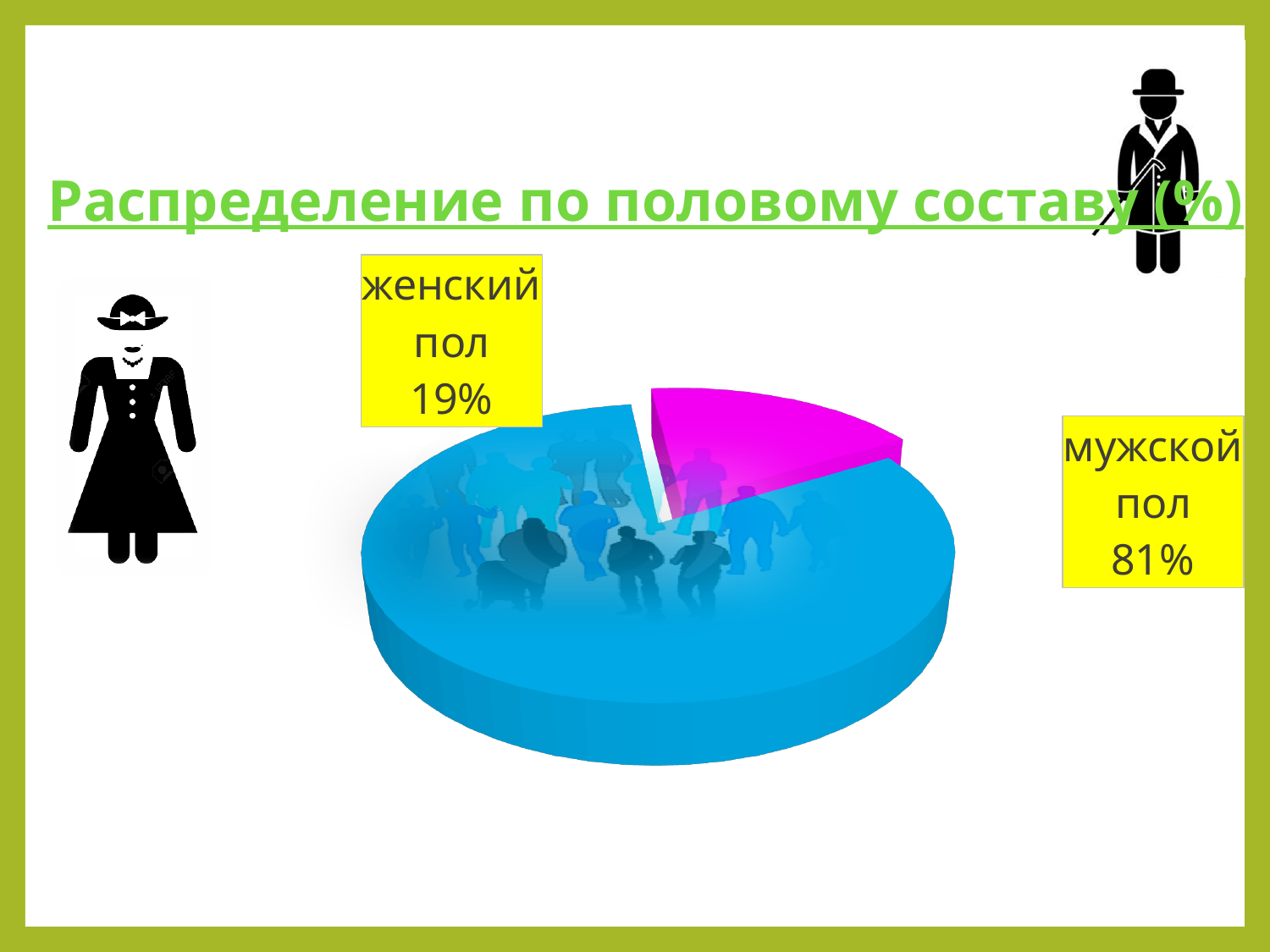
What percentage does the slice labelled "женский пол" represent? 19% Which category has the smallest share of the pie? женский пол Which is larger: the share for "женский пол" or the share for "мужской пол"? мужской пол What is the difference in percentage points between the "мужской пол" and "женский пол" slices? 62 What percentage does the slice labelled "мужской пол" represent? 81% What kind of chart is shown on the slide? pie chart What colour is the slice for "мужской пол"? blue What share of the pie does the "женский пол" slice take? 19% Which category has the largest share of the pie? мужской пол What is the title of the chart on the slide? Распределение по половому составу (%) How many slices does the pie chart have? 2